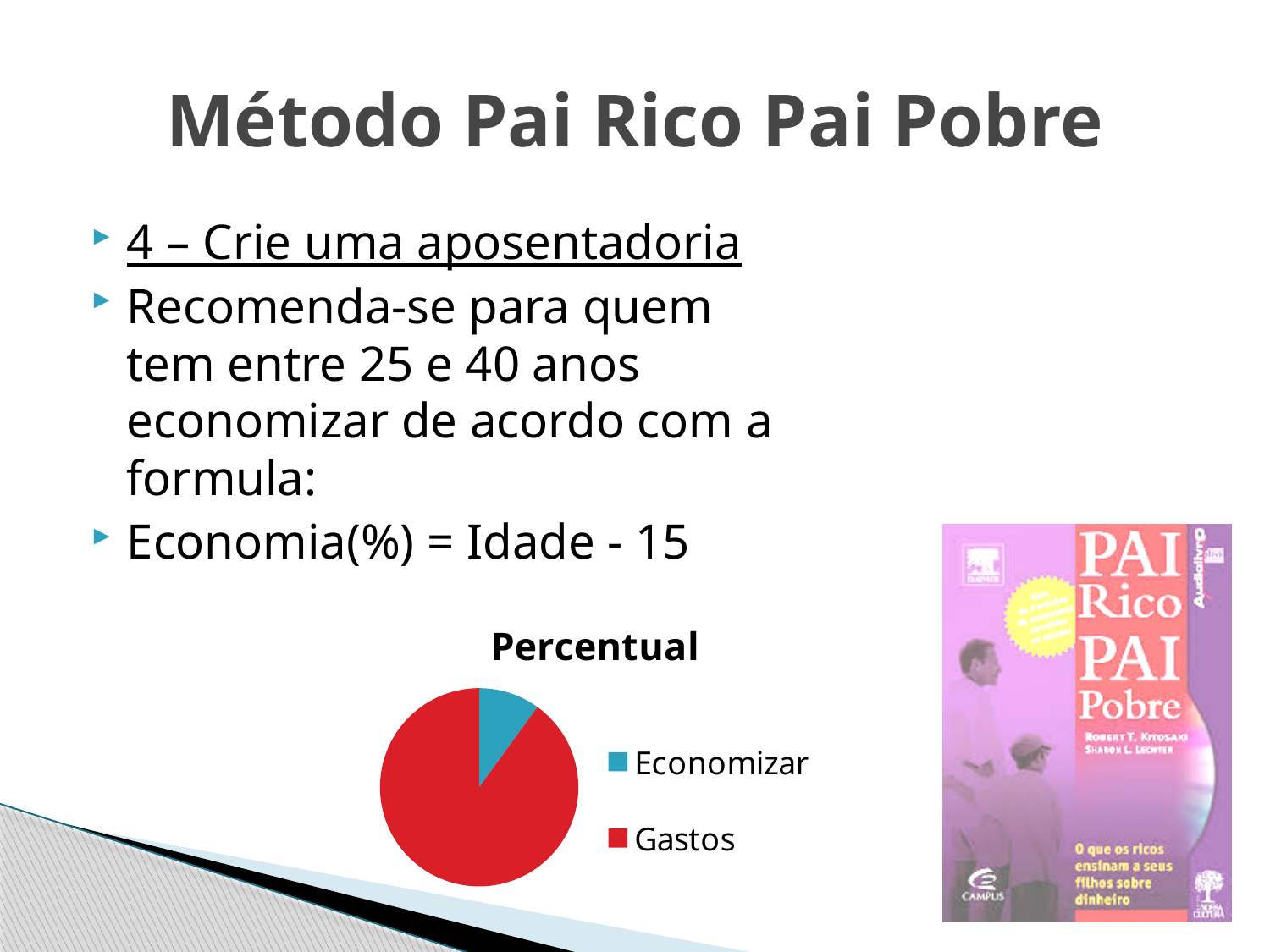
Which category has the largest slice of the pie chart? Gastos How many entries does the chart legend list? 2 Which slice is larger, Economizar or Gastos? Gastos What kind of chart is shown on the slide? pie chart What colour is the Economizar slice in the pie chart? blue Which category has the smallest slice of the pie chart? Economizar What is the title of the chart? Percentual Which category is shown in red in the pie chart? Gastos How many slices does the pie chart have? 2